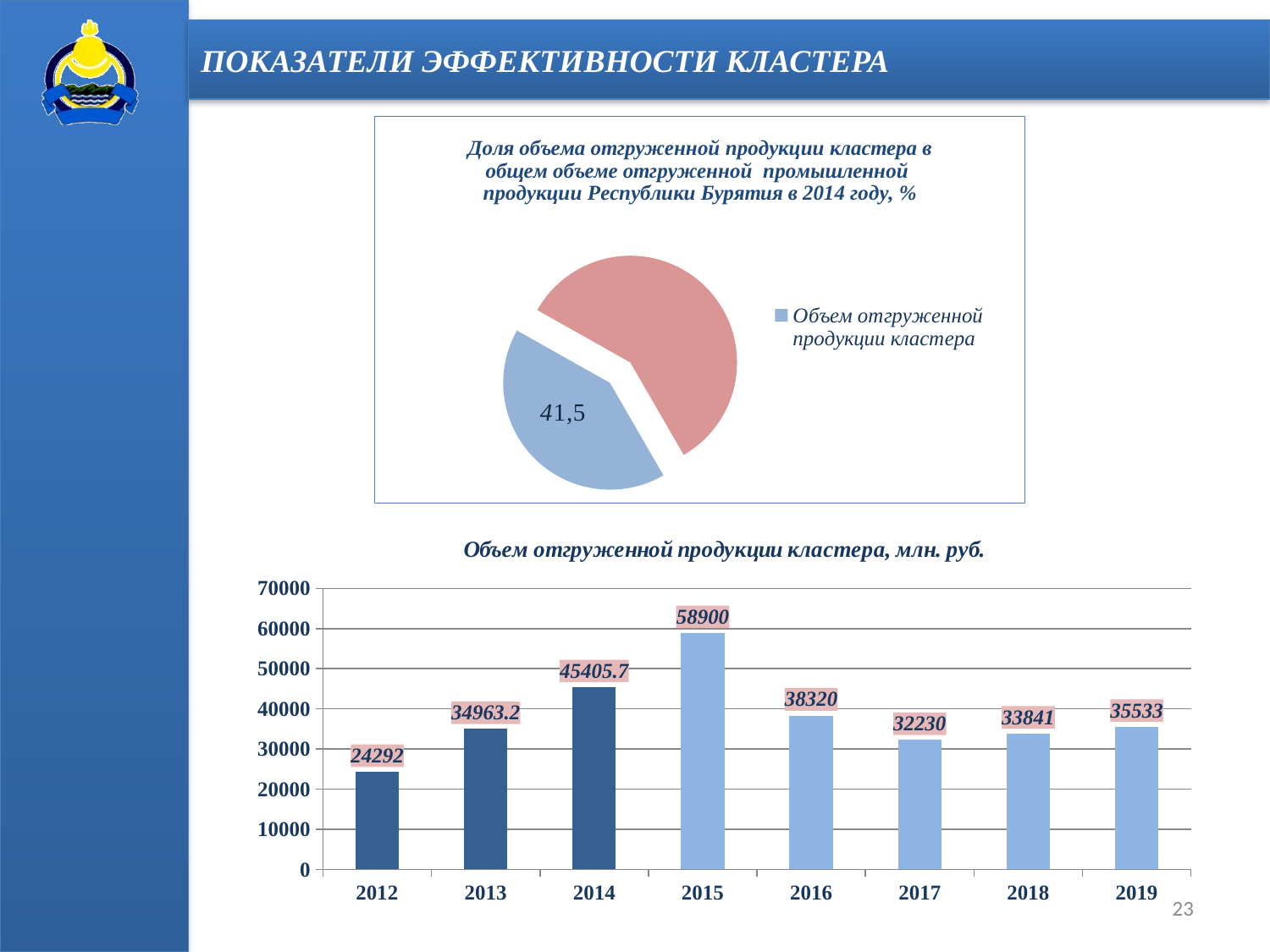
What kind of chart is the top chart on the slide? pie chart In the bar chart 'Объем отгруженной продукции кластера, млн. руб.', what is the value for 2012? 24292 In the bar chart 'Объем отгруженной продукции кластера, млн. руб.', what is the difference between the values for 2015 and 2016? 20580 In the bar chart 'Объем отгруженной продукции кластера, млн. руб.', do the values rise or fall from 2012 to 2015? rise In the bar chart 'Объем отгруженной продукции кластера, млн. руб.', which year has the lowest value? 2012 In the bar chart 'Объем отгруженной продукции кластера, млн. руб.', how many years are shown on the x axis? 8 In the bar chart 'Объем отгруженной продукции кластера, млн. руб.', what is the value for 2015? 58900 In the bar chart 'Объем отгруженной продукции кластера, млн. руб.', which is larger, the value for 2017 or the value for 2019? 2019 In the bar chart 'Объем отгруженной продукции кластера, млн. руб.', what is the value for 2014? 45405.7 What kind of chart is the bottom chart 'Объем отгруженной продукции кластера, млн. руб.'? bar chart In the bar chart 'Объем отгруженной продукции кластера, млн. руб.', which year has the highest value? 2015 In the pie chart at the top of the slide, what share is printed on the blue slice? 41,5